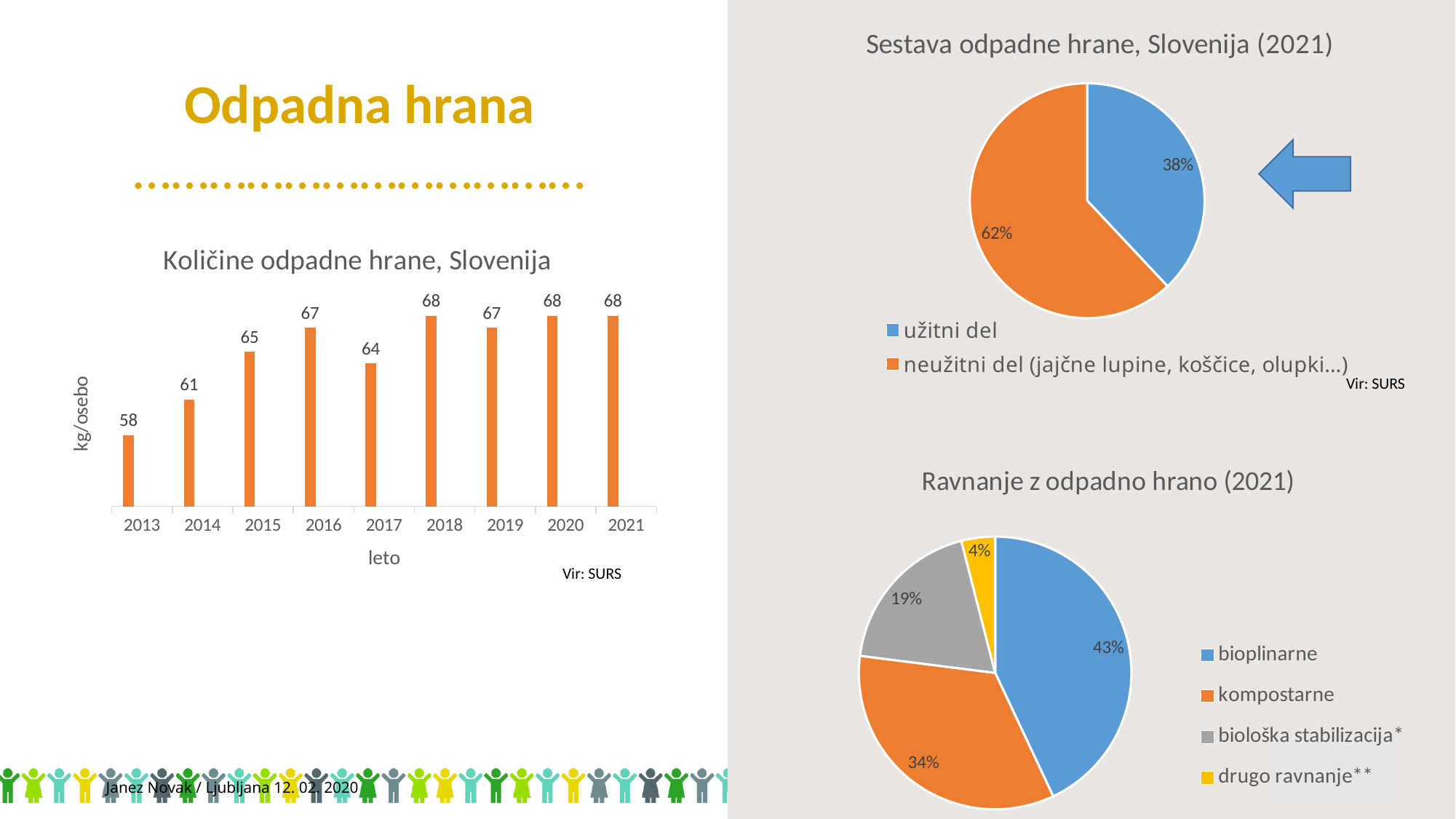
In the 'Ravnanje z odpadno hrano (2021)' pie chart, what share is 'kompostarne'? 34% In the 'Ravnanje z odpadno hrano (2021)' pie chart, which category has the smallest share? drugo ravnanje** In the 'Sestava odpadne hrane, Slovenija (2021)' pie chart, what share is 'užitni del'? 38% In the 'Količine odpadne hrane, Slovenija' chart, what is the value for 2017? 64 In the 'Količine odpadne hrane, Slovenija' chart, do the values generally rise or fall from 2013 to 2021? rise In the 'Količine odpadne hrane, Slovenija' chart, which is larger, the value for 2016 or the value for 2017? 2016 What kind of chart is 'Količine odpadne hrane, Slovenija'? bar chart How many years are shown in the 'Količine odpadne hrane, Slovenija' chart? 9 In the 'Količine odpadne hrane, Slovenija' chart, which year has the lowest value? 2013 In the 'Količine odpadne hrane, Slovenija' chart, what is the difference between the values for 2021 and 2013? 10 How many entries does the legend of the 'Ravnanje z odpadno hrano (2021)' pie chart list? 4 In the 'Količine odpadne hrane, Slovenija' chart, what is the value for 2013? 58